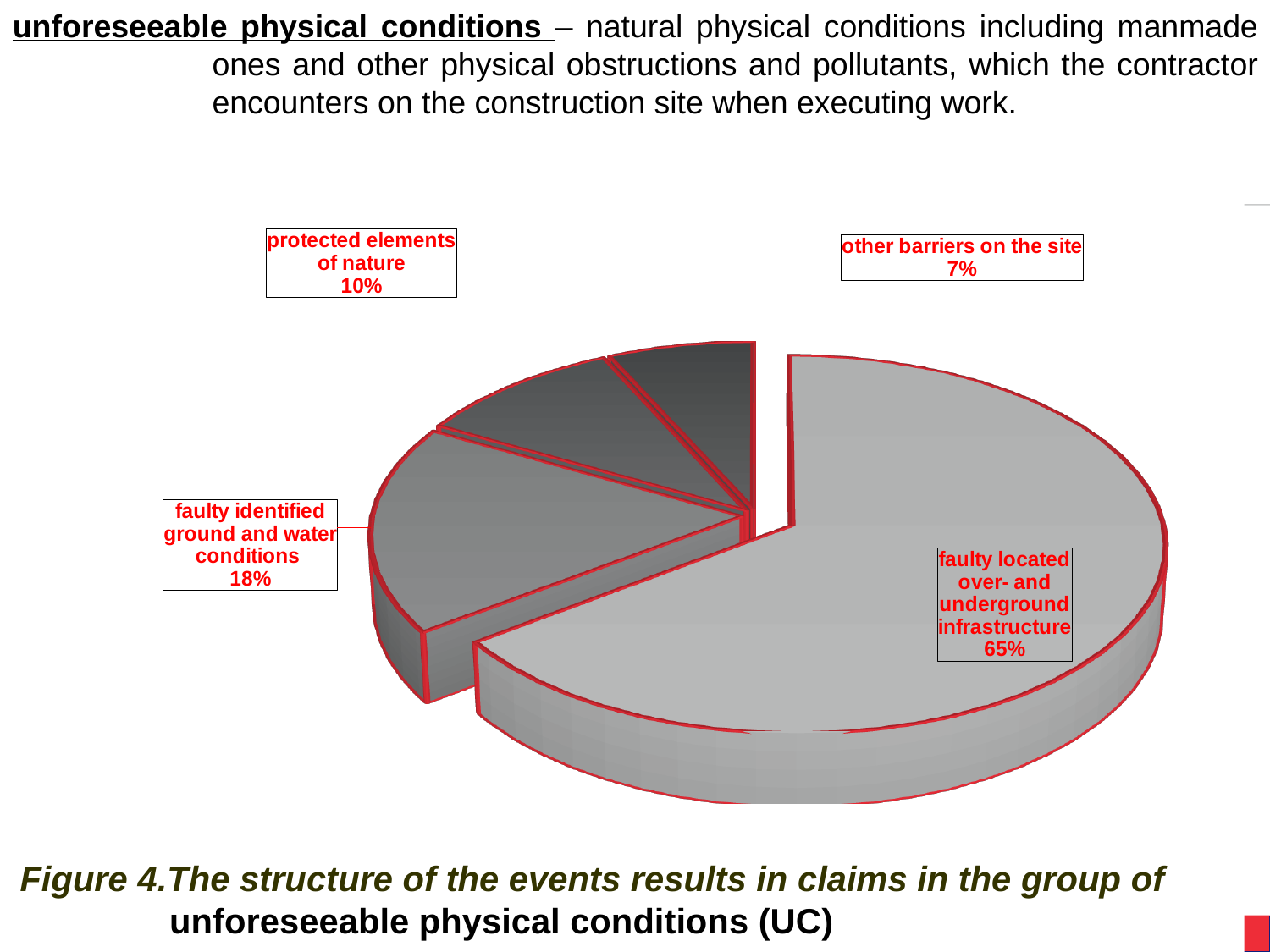
What share of the pie is 'other barriers on the site'? 7% What is the figure caption of the chart? Figure 4. The structure of the events results in claims in the group of unforeseeable physical conditions (UC) Which category has the largest share of the pie? faulty located over- and underground infrastructure What share of the pie is 'faulty identified ground and water conditions'? 18% What is the difference in percentage points between 'protected elements of nature' and 'other barriers on the site'? 3 percentage points What share of the pie is 'faulty located over- and underground infrastructure'? 65% What is the difference in percentage points between 'faulty located over- and underground infrastructure' and 'faulty identified ground and water conditions'? 47 percentage points Which is larger: the share for 'faulty identified ground and water conditions' or for 'protected elements of nature'? faulty identified ground and water conditions What share of the pie is 'protected elements of nature'? 10% What kind of chart is shown on the slide? pie chart Which category has the smallest share of the pie? other barriers on the site How many slices does the pie chart have? 4